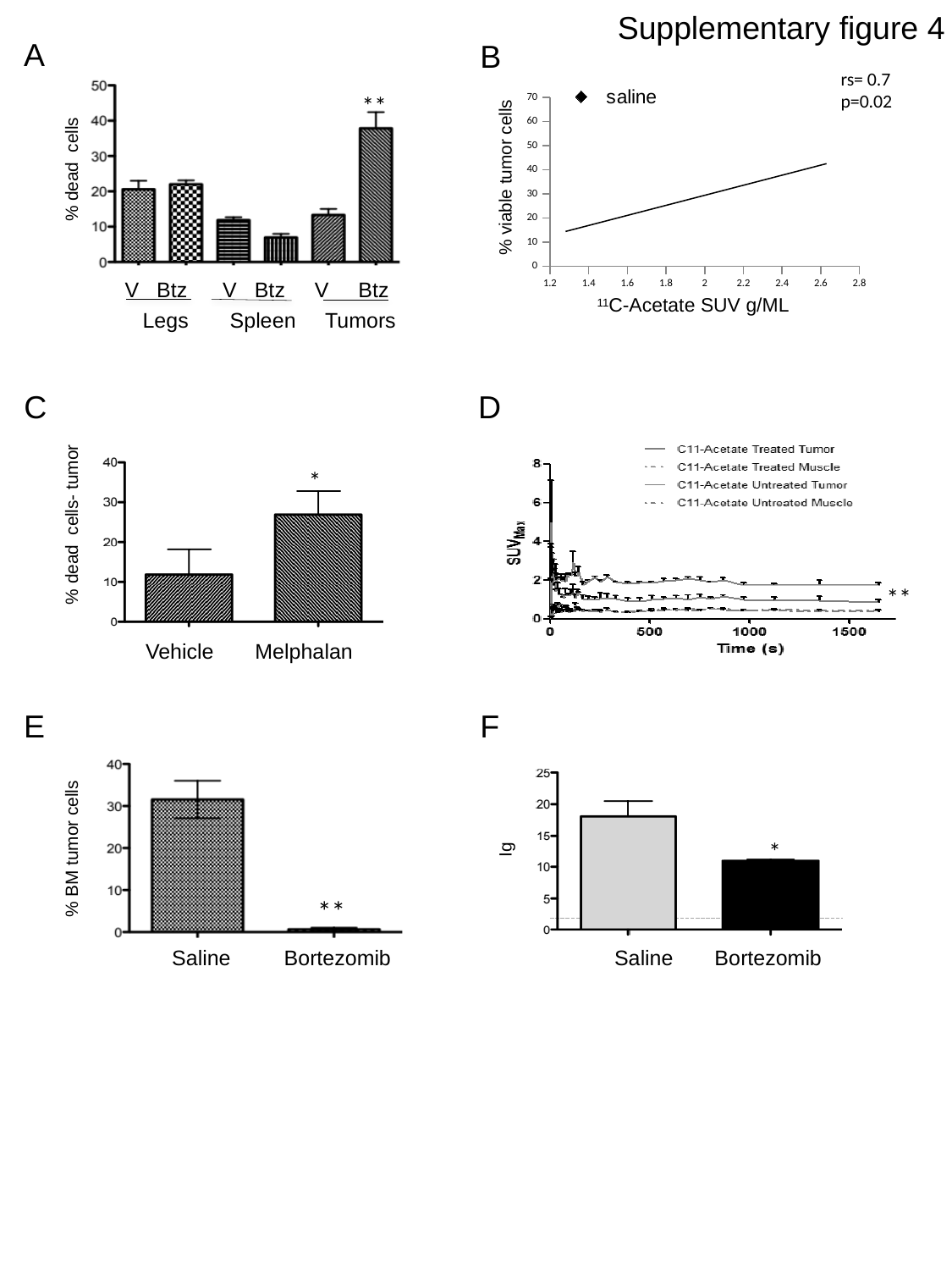
In panel F, which bar is larger, Saline or Bortezomib? Saline In panel A, which bar is the highest? Tumors Btz In panel A, is the value for Tumors Btz greater or less than 30? greater In panel C, is the value for Melphalan greater or less than 20? greater In panel E, is the value for Bortezomib greater or less than 10? less In panel A, how many bars are plotted? 6 In panel B, what correlation coefficient (rs) is shown? rs= 0.7 In panel B, do the values rise or fall as 11C-Acetate SUV increases along the x axis? rise In panel C, which bar is larger, Vehicle or Melphalan? Melphalan In panel A, which bar is the lowest? Spleen Btz In panel D, how many series does the legend list? 4 What kind of chart is panel D? line chart